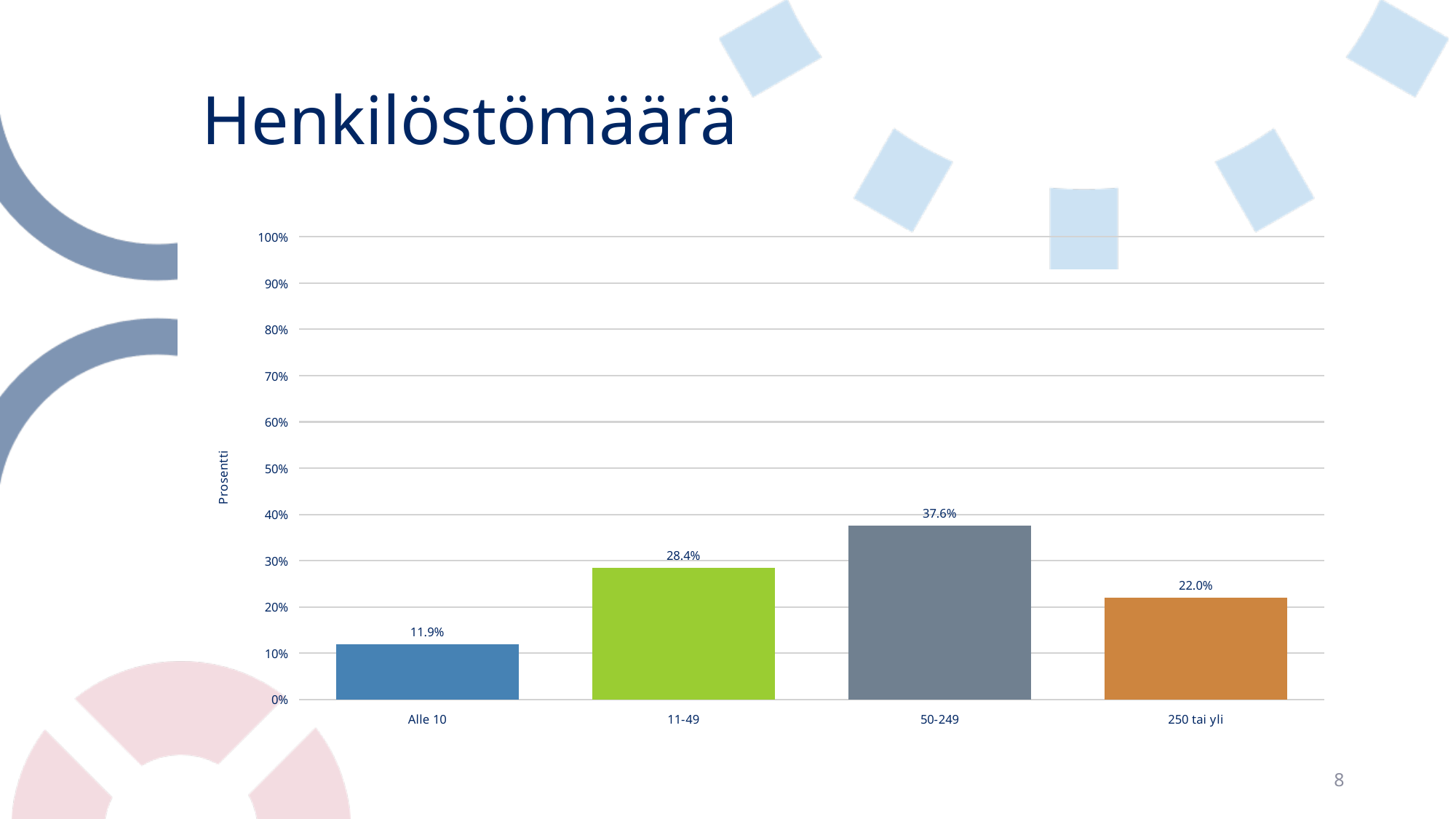
What is the value for the 'Alle 10' category? 11.9% What kind of chart is shown on the slide? bar chart What is the value for the '250 tai yli' category? 22.0% How many categories are shown on the x axis? 4 Which category has the highest value? 50-249 What is the value for the '11-49' category? 28.4% What is the difference between the values for '50-249' and '11-49'? 9.2% Which is larger, the value for '11-49' or the value for '250 tai yli'? 11-49 Is the value for '50-249' greater or less than 40%? less Which category has the lowest value? Alle 10 What is the label of the vertical axis? Prosentti What is the value for the '50-249' category? 37.6%